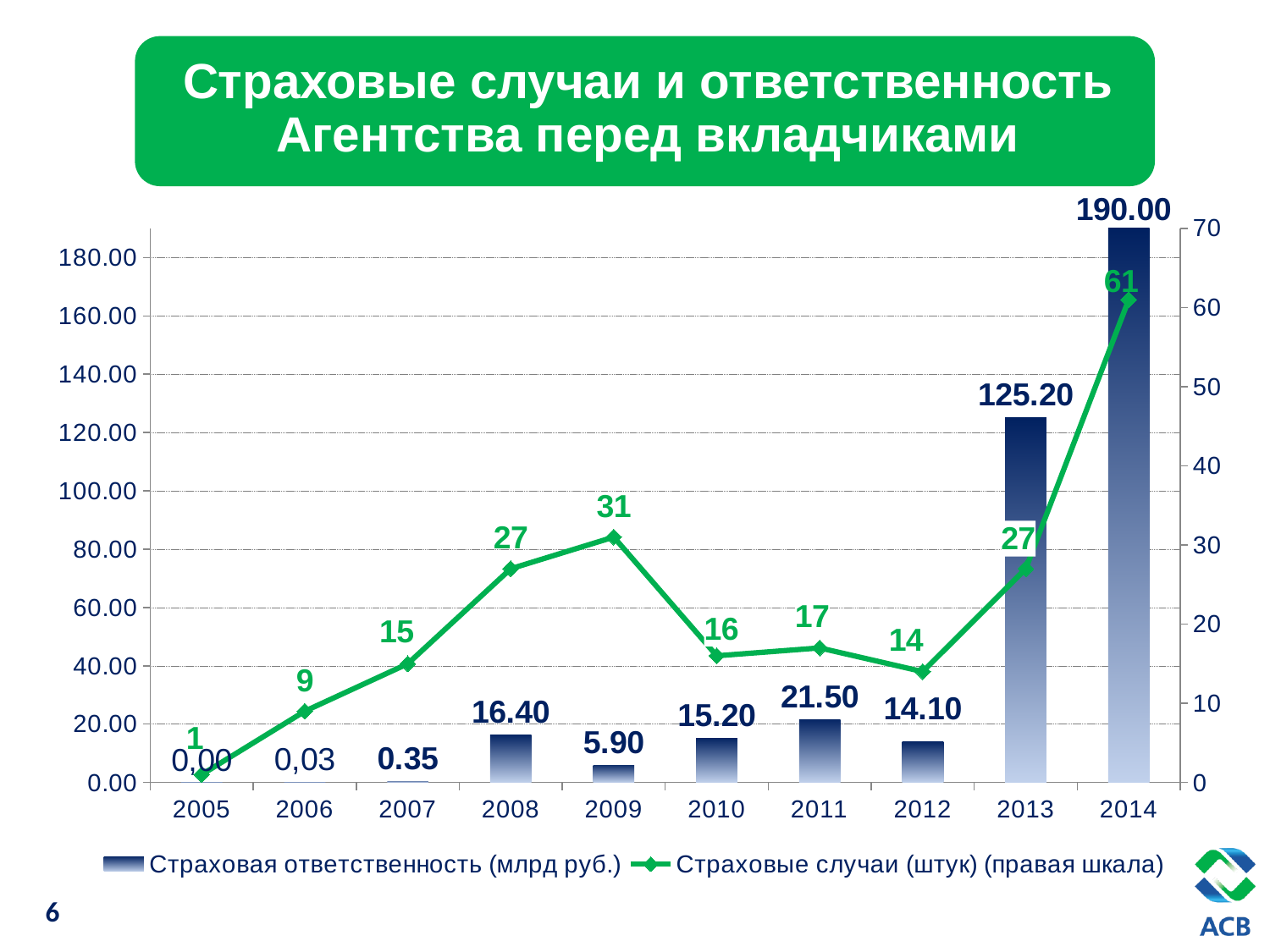
How many series does the legend list? 2 Which year has more Страховые случаи (штук), 2010 or 2011? 2011 How many years are shown on the x axis of the chart? 10 Which year has the highest value of Страховая ответственность (млрд руб.)? 2014 How many Страховые случаи (штук) are shown for 2009? 31 Which year has the lowest number of Страховые случаи (штук)? 2005 How many Страховые случаи (штук) are shown for 2006? 9 What is the value of Страховая ответственность (млрд руб.) for 2011? 21.50 Which series is plotted on the right-hand scale according to the legend? Страховые случаи (штук) Is the value of Страховая ответственность (млрд руб.) for 2013 greater or less than 100.00? greater What is the difference in Страховая ответственность (млрд руб.) between 2014 and 2013? 64.80 What is the value of Страховая ответственность (млрд руб.) for 2014? 190.00